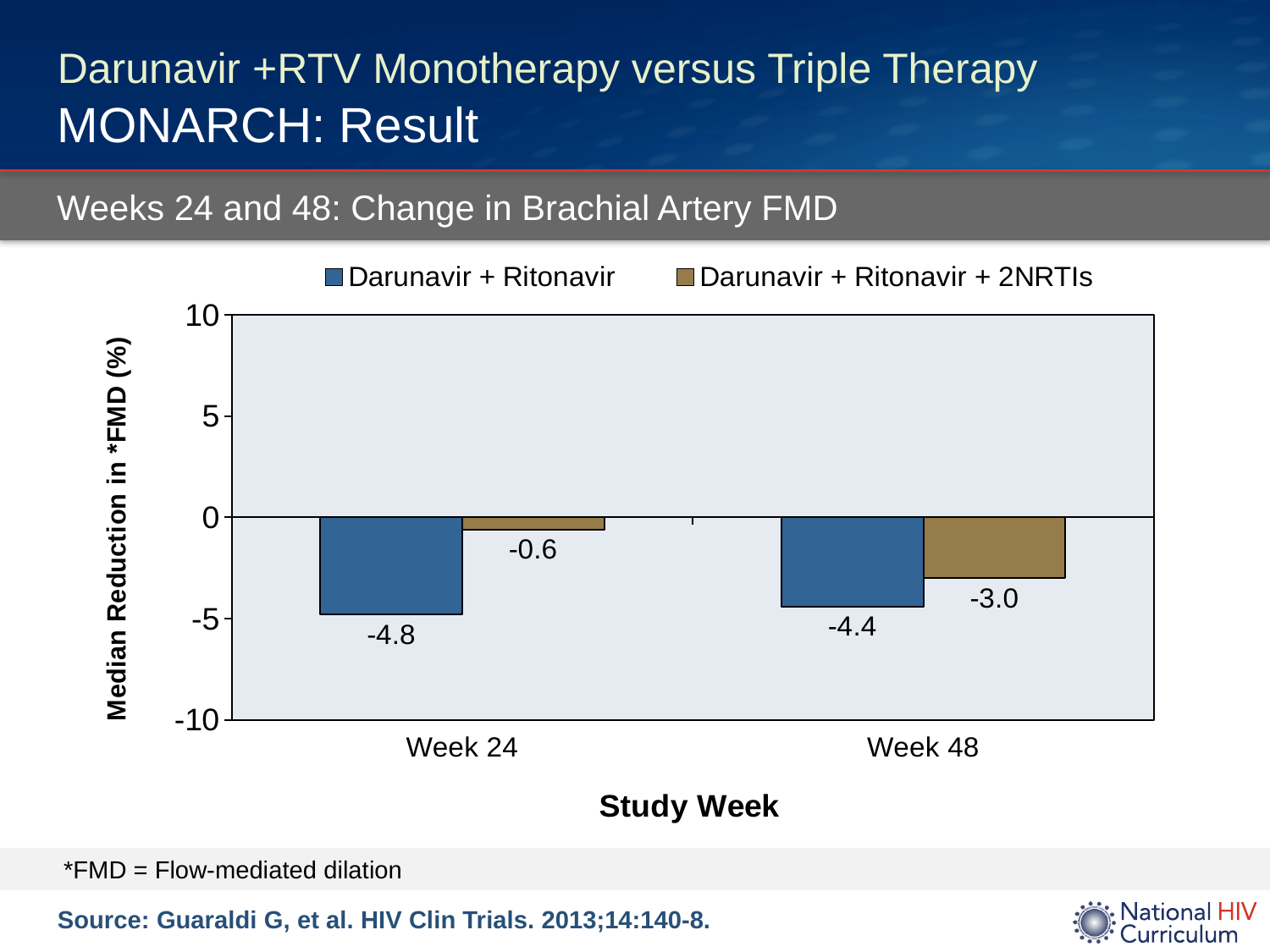
What kind of chart is shown on the slide? Bar chart What is the difference between the Darunavir + Ritonavir and Darunavir + Ritonavir + 2NRTIs values at Week 24? 4.2 What is the difference between the Darunavir + Ritonavir and Darunavir + Ritonavir + 2NRTIs values at Week 48? 1.4 Which bar shows the highest value on the chart? Darunavir + Ritonavir + 2NRTIs at Week 24 What is the value for Darunavir + Ritonavir at Week 24? -4.8 Which series has the larger value at Week 48, Darunavir + Ritonavir or Darunavir + Ritonavir + 2NRTIs? Darunavir + Ritonavir + 2NRTIs What is the value for Darunavir + Ritonavir + 2NRTIs at Week 48? -3.0 What is the value for Darunavir + Ritonavir + 2NRTIs at Week 24? -0.6 Which bar shows the lowest value on the chart? Darunavir + Ritonavir at Week 24 What is the value for Darunavir + Ritonavir at Week 48? -4.4 How many study week categories are shown on the x axis? 2 How many series does the legend list? 2